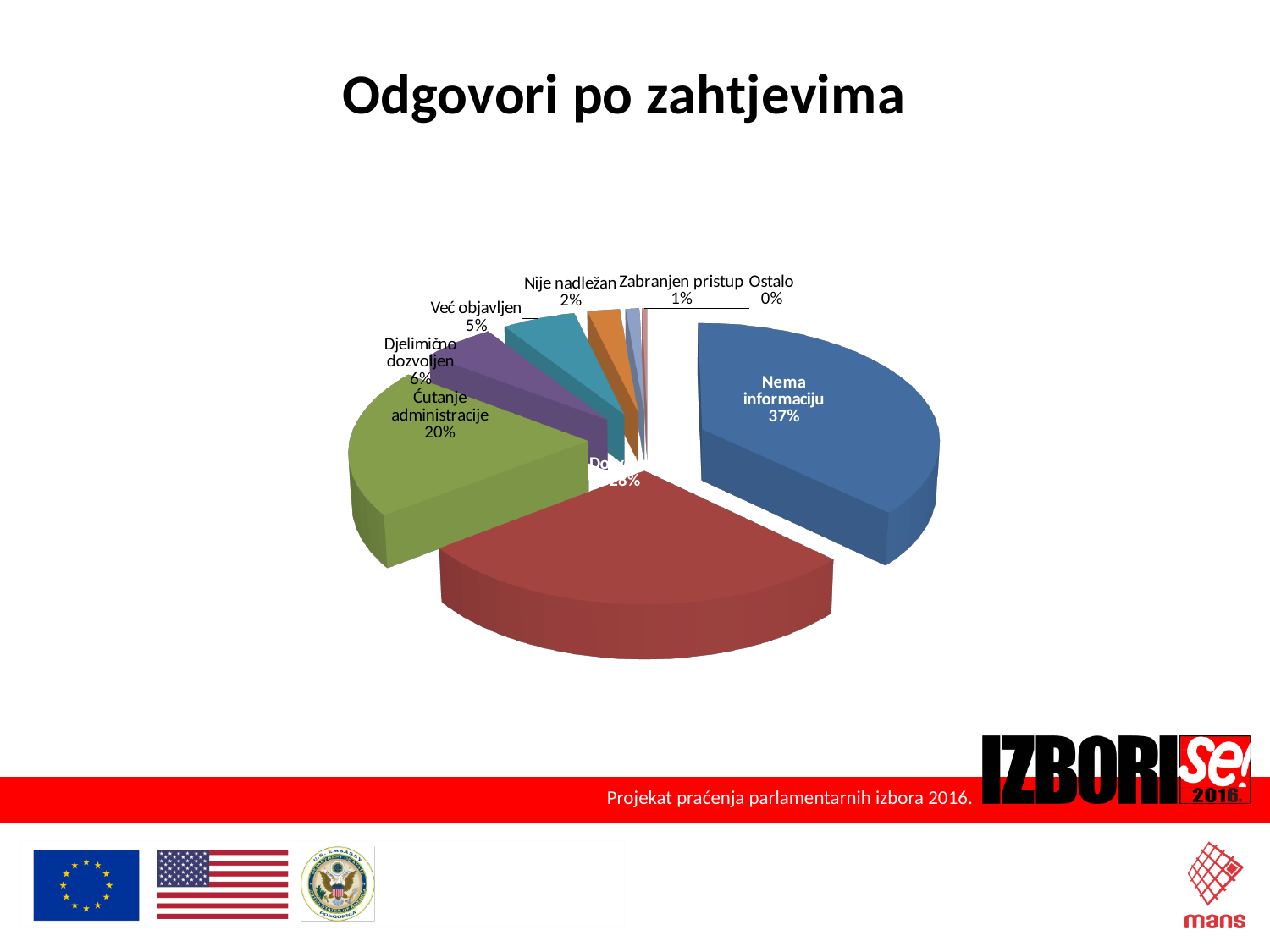
Which category has the largest slice of the pie? Nema informaciju What kind of chart is shown on the slide? pie chart What share of the pie is 'Zabranjen pristup'? 1% Which category has the smallest slice of the pie? Ostalo What share of the pie is 'Nema informaciju'? 37% What share of the pie is 'Već objavljen'? 5% What is the title of the chart? Odgovori po zahtjevima What is the difference between the shares of 'Nema informaciju' and 'Ćutanje administracije'? 17%